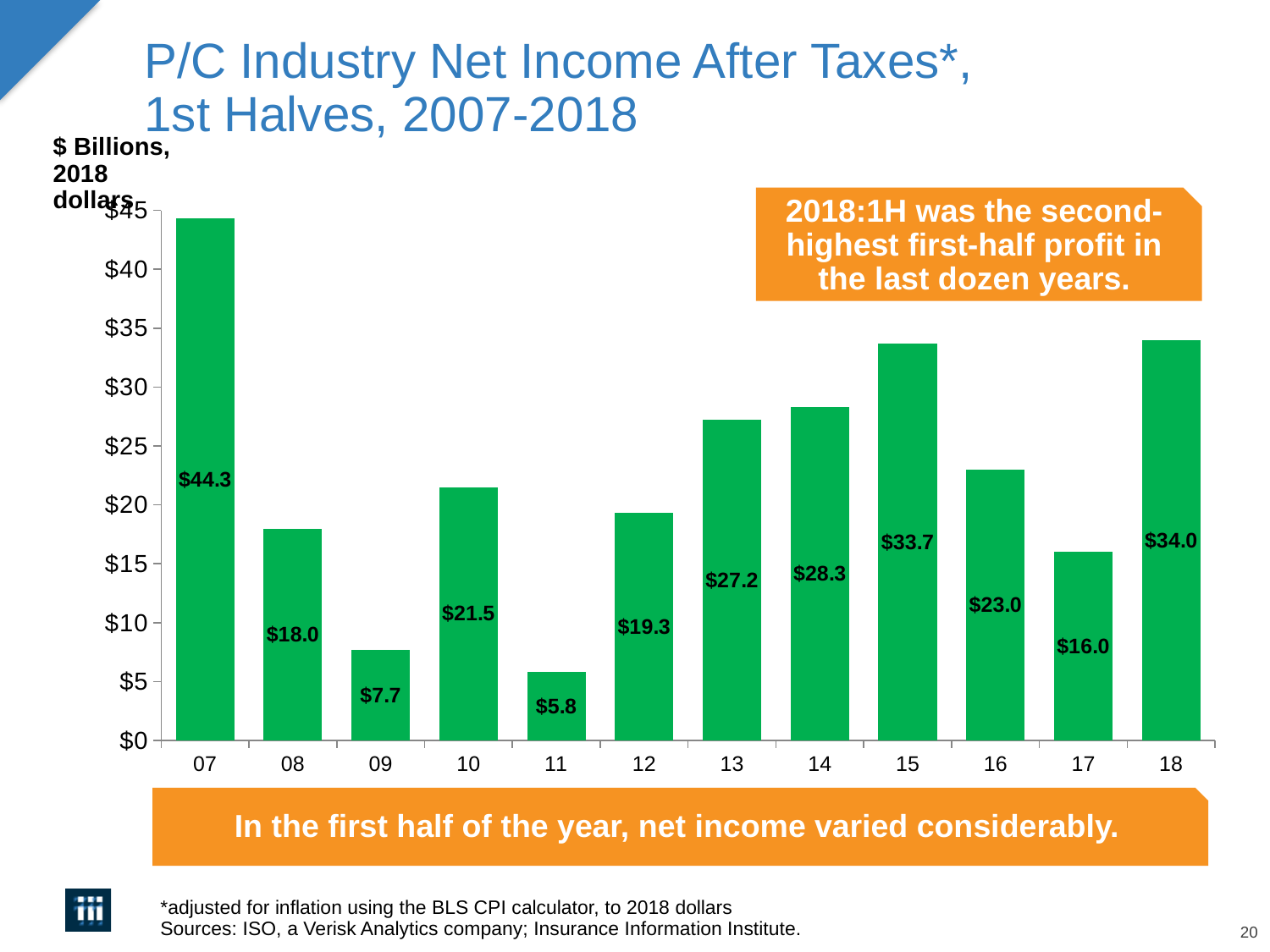
Which is larger, the value for 2013 or the value for 2014? 14 What type of chart is shown on the slide? bar chart What was the P/C industry net income after taxes in the first half of 2007? $44.3 In what units are the values on the chart expressed? $ Billions, 2018 dollars Which year had the lowest first-half net income? 11 Is the value for 2010 greater or less than $20? greater What value is shown for the first half of 2011? $5.8 How many years are shown on the x axis? 12 Did the net income rise or fall from 2016 to 2017? fall Which year had the highest first-half net income? 07 What is the difference between the 2015 and 2016 first-half values? $10.7 What was the net income after taxes in the first half of 2018? $34.0